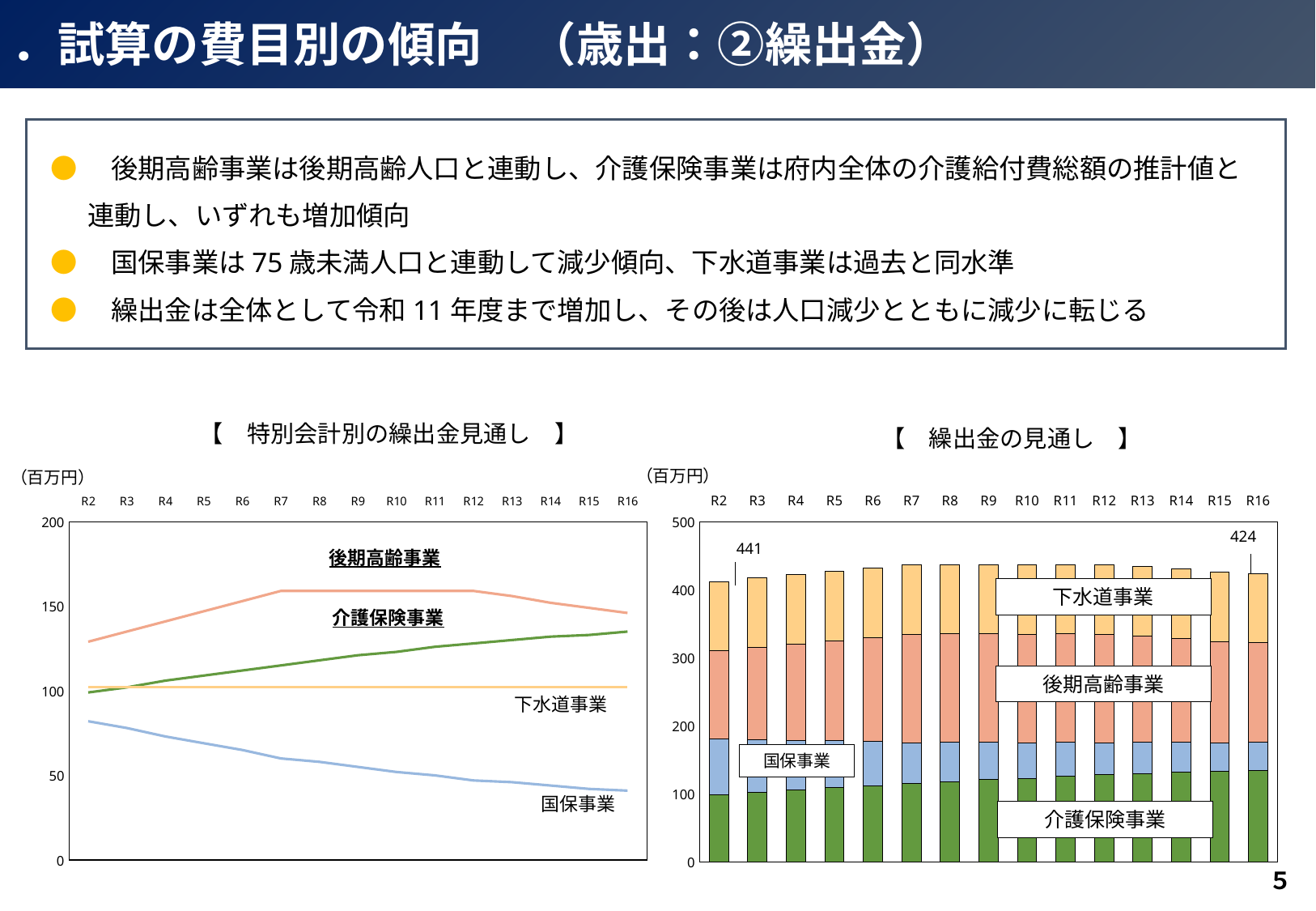
What kind of chart is the left chart titled 特別会計別の繰出金見通し? line chart In the left chart (特別会計別の繰出金見通し), how many series are plotted? 4 In the right chart (繰出金の見通し), which series is at the bottom of each stacked bar? 介護保険事業 In the left chart (特別会計別の繰出金見通し), does the 介護保険事業 line rise or fall from R2 to R16? rise In the left chart (特別会計別の繰出金見通し), which series has the highest value at R2? 後期高齢事業 In the right chart (繰出金の見通し), what is the total value labelled for R2? 441 In the left chart (特別会計別の繰出金見通し), how many fiscal years are plotted along the x axis? 15 In the left chart (特別会計別の繰出金見通し), which series has the lowest value at R16? 国保事業 In the left chart (特別会計別の繰出金見通し), is the value for 後期高齢事業 at R2 greater or less than 150? less In the left chart (特別会計別の繰出金見通し), is the value for 国保事業 at R16 greater or less than 50? less In the right chart (繰出金の見通し), what is the difference between the labelled totals for R2 and R16? 17 In the left chart (特別会計別の繰出金見通し), does the 国保事業 line rise or fall from R2 to R16? fall